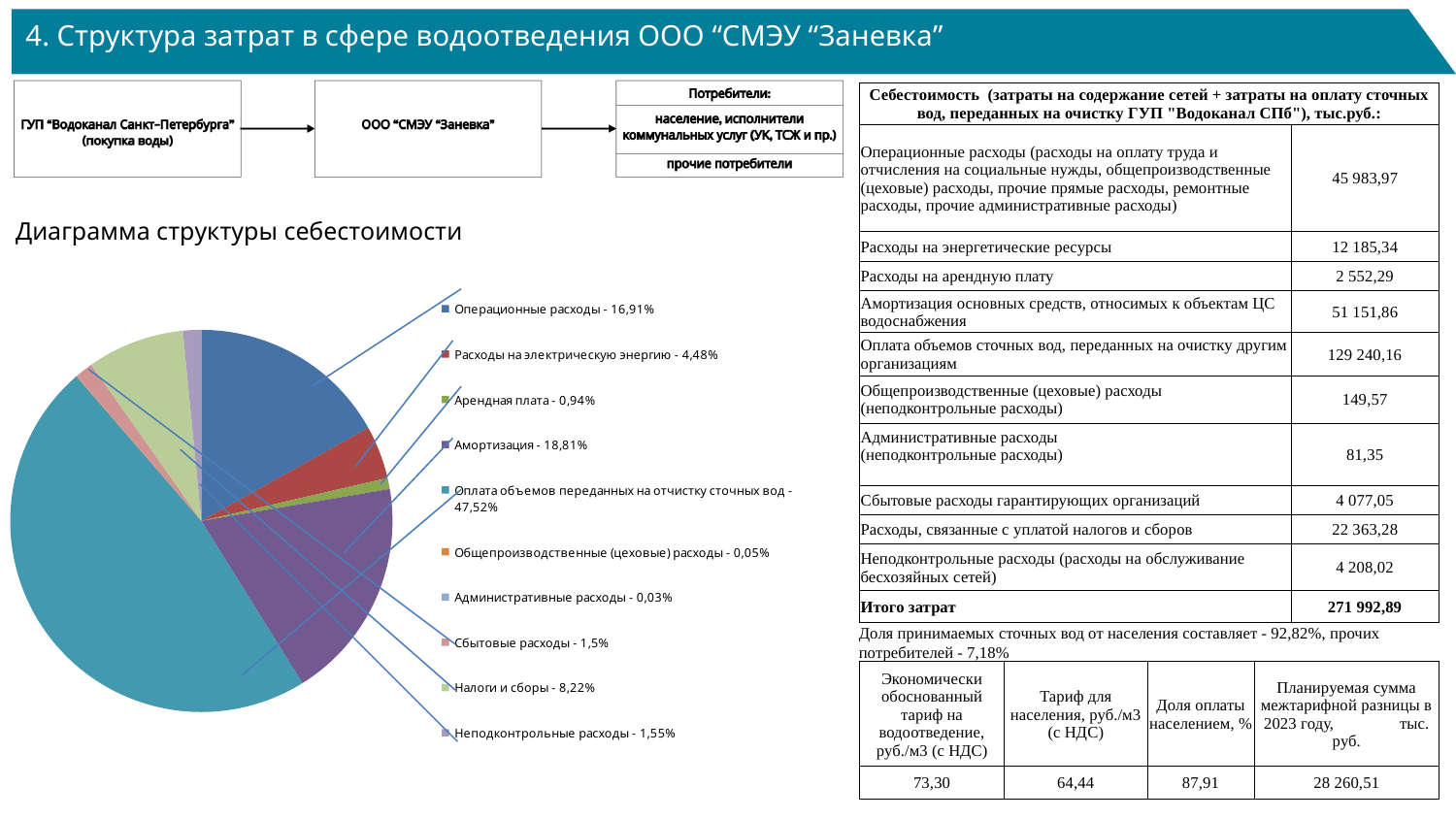
What type of chart is shown on the slide? Pie chart What percentage is shown for Операционные расходы in the pie chart? 16,91% Which category has the smallest share of the pie chart? Административные расходы - 0,03% What share of the pie does Сбытовые расходы represent? 1,5% Which is larger in the pie chart: Амортизация or Операционные расходы? Амортизация What percentage is shown for Налоги и сборы in the pie chart? 8,22% How many categories does the pie chart's legend list? 10 What is the title of the chart on the slide? Диаграмма структуры себестоимости What percentage is shown for Амортизация in the pie chart? 18,81% What is the difference in percentage points between Оплата объемов переданных на отчистку сточных вод and Амортизация? 28,71 Which category has the largest share of the pie chart? Оплата объемов переданных на отчистку сточных вод - 47,52% What is the difference in percentage points between Налоги и сборы and Расходы на электрическую энергию? 3,74